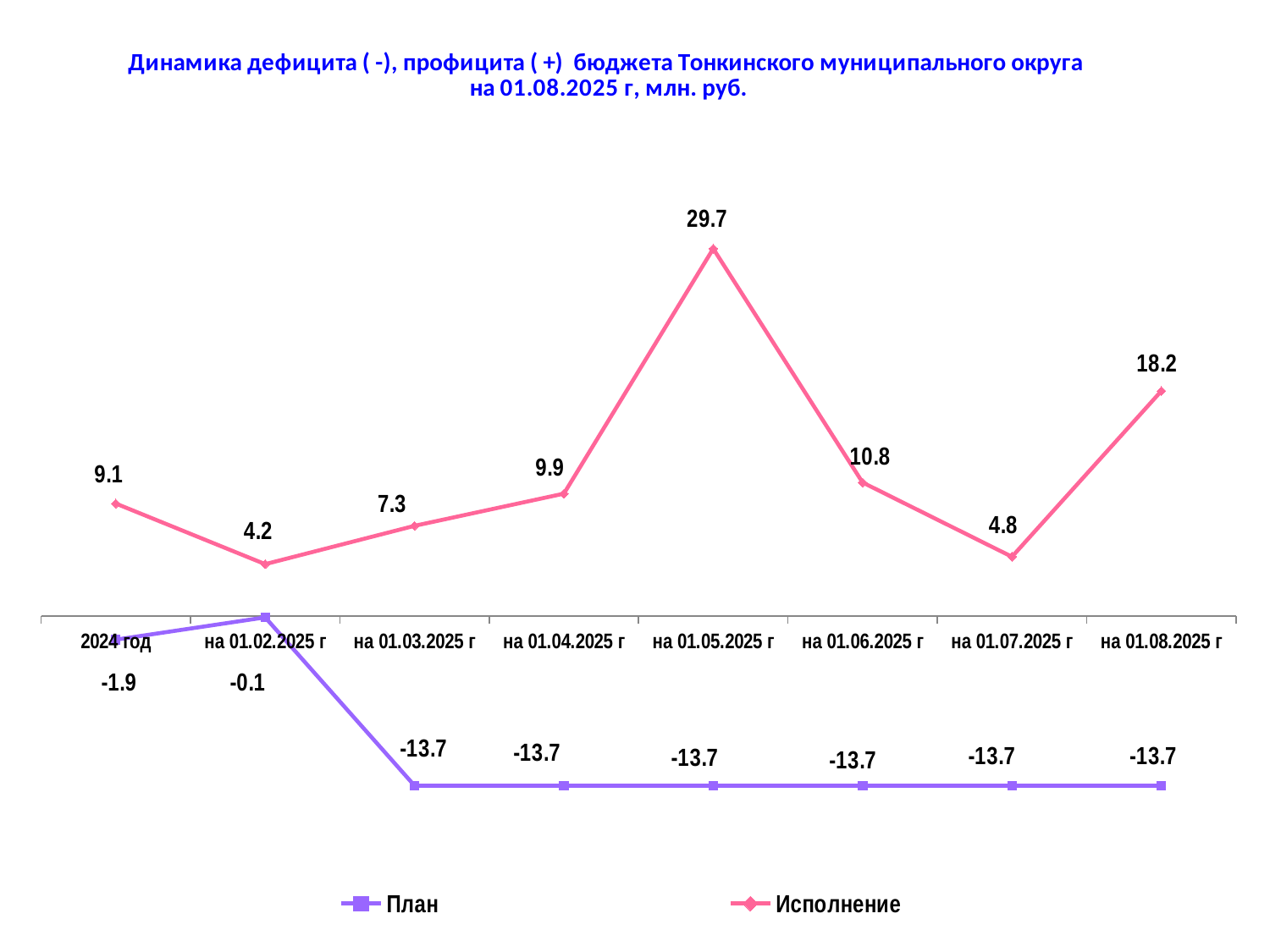
How many dates (categories) are shown on the x axis? 8 At which date does the Исполнение series have its lowest value? на 01.02.2025 г What is the value of План for 2024 год? -1.9 What is the value of План for на 01.02.2025 г? -0.1 What is the value of Исполнение for на 01.08.2025 г? 18.2 What kind of chart is shown on the slide? Line chart How many series does the legend list? 2 What is the difference between the Исполнение values for на 01.05.2025 г and на 01.06.2025 г? 18.9 Does the План series rise or fall from на 01.02.2025 г to на 01.03.2025 г? Fall Which is larger: the Исполнение value for 2024 год or for на 01.04.2025 г? на 01.04.2025 г What is the value of Исполнение for на 01.05.2025 г? 29.7 At which date does the Исполнение series reach its highest value? на 01.05.2025 г